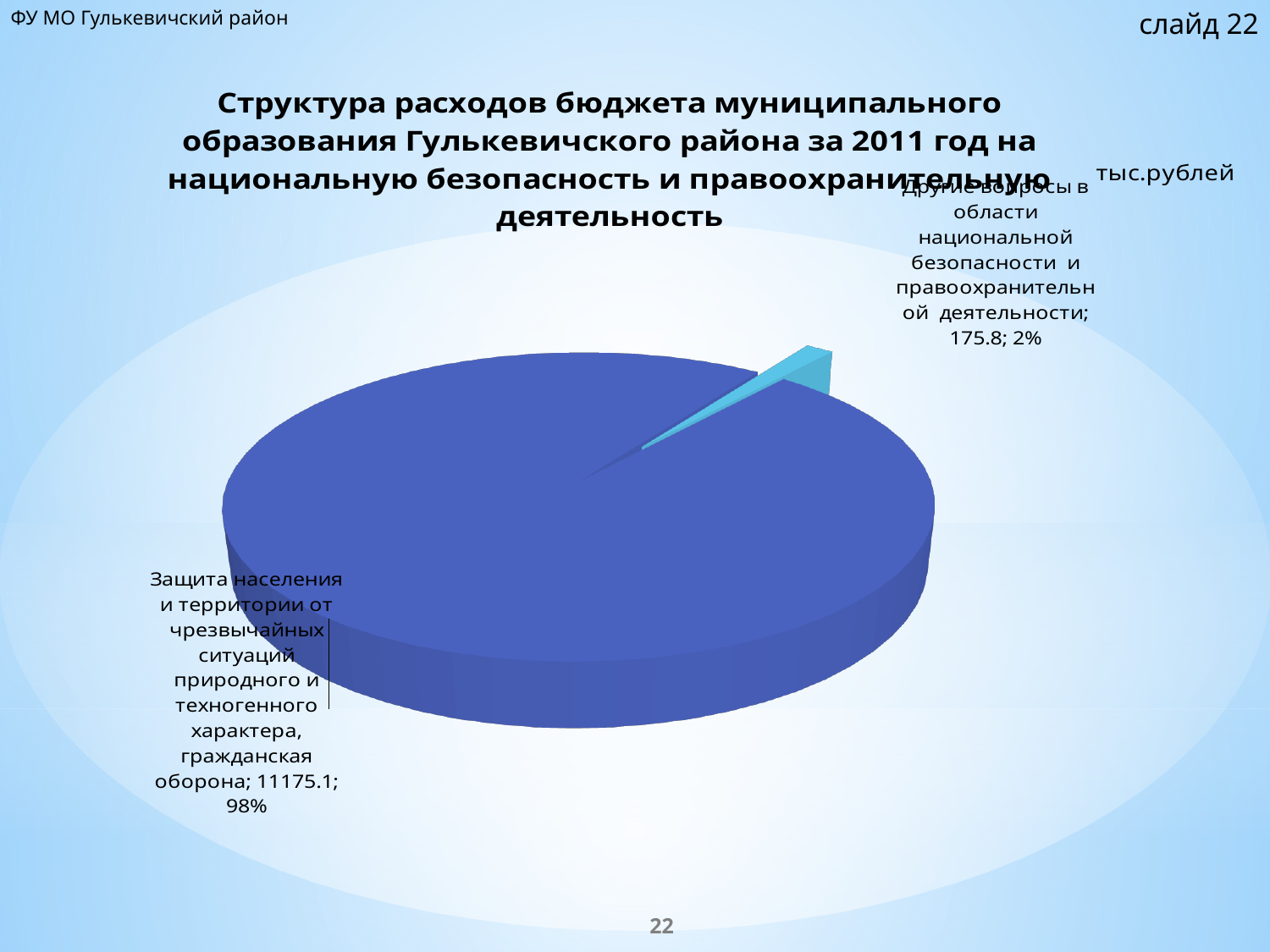
What is the difference between the values for "Защита населения и территории от чрезвычайных ситуаций..." and "Другие вопросы в области национальной безопасности..."? 10999.3 What share of the pie does "Защита населения и территории от чрезвычайных ситуаций природного и техногенного характера, гражданская оборона" represent? 98% Which category has the smallest slice of the pie? Другие вопросы в области национальной безопасности и правоохранительной деятельности What share of the pie does "Другие вопросы в области национальной безопасности и правоохранительной деятельности" represent? 2% What is the value for "Защита населения и территории от чрезвычайных ситуаций природного и техногенного характера, гражданская оборона"? 11175.1 What is the total of the two values shown in the pie chart? 11350.9 Which is larger: the value for "Защита населения и территории от чрезвычайных ситуаций..." or for "Другие вопросы в области национальной безопасности..."? Защита населения и территории от чрезвычайных ситуаций природного и техногенного характера, гражданская оборона What is the value for "Другие вопросы в области национальной безопасности и правоохранительной деятельности"? 175.8 What kind of chart is shown on the slide? pie chart Which category has the largest slice of the pie? Защита населения и территории от чрезвычайных ситуаций природного и техногенного характера, гражданская оборона In what units are the values in the chart expressed, according to the slide? тыс.рублей How many slices does the pie chart have? 2